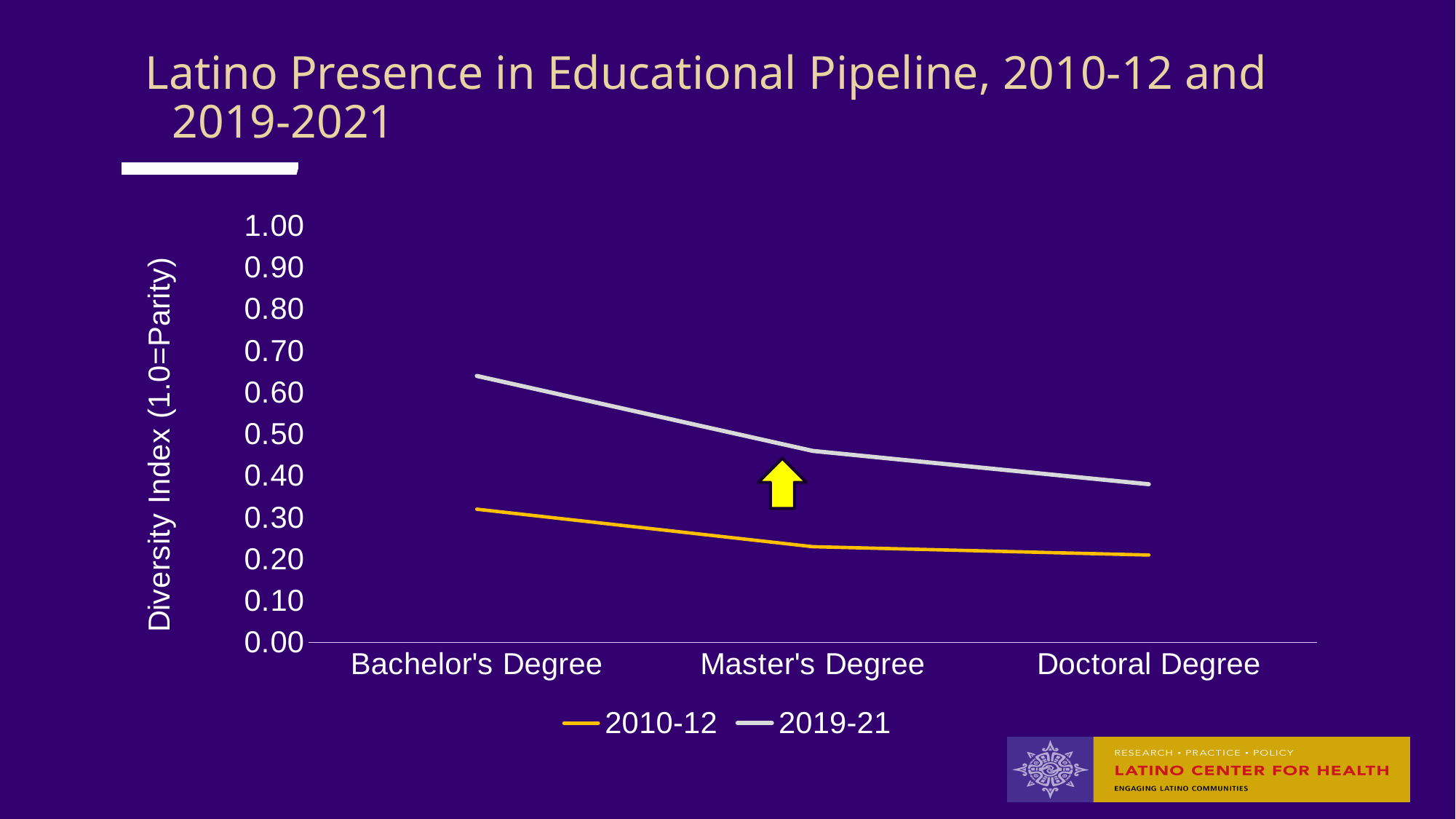
Which degree category has the highest value for the 2019-21 series? Bachelor's Degree Is the 2019-21 value for Master's Degree greater or less than 0.50? less How many degree categories are plotted along the x axis? 3 Which degree category has the lowest value for the 2010-12 series? Doctoral Degree Do the values for the 2019-21 series rise or fall from Bachelor's Degree to Doctoral Degree? fall At Bachelor's Degree, which series has the larger value, 2010-12 or 2019-21? 2019-21 Is the 2010-12 value for Doctoral Degree greater or less than 0.30? less Is the 2010-12 value for Bachelor's Degree greater or less than 0.40? less What kind of chart is shown on the slide? line chart What is the label on the vertical axis of the chart? Diversity Index (1.0=Parity) How many series does the legend list? 2